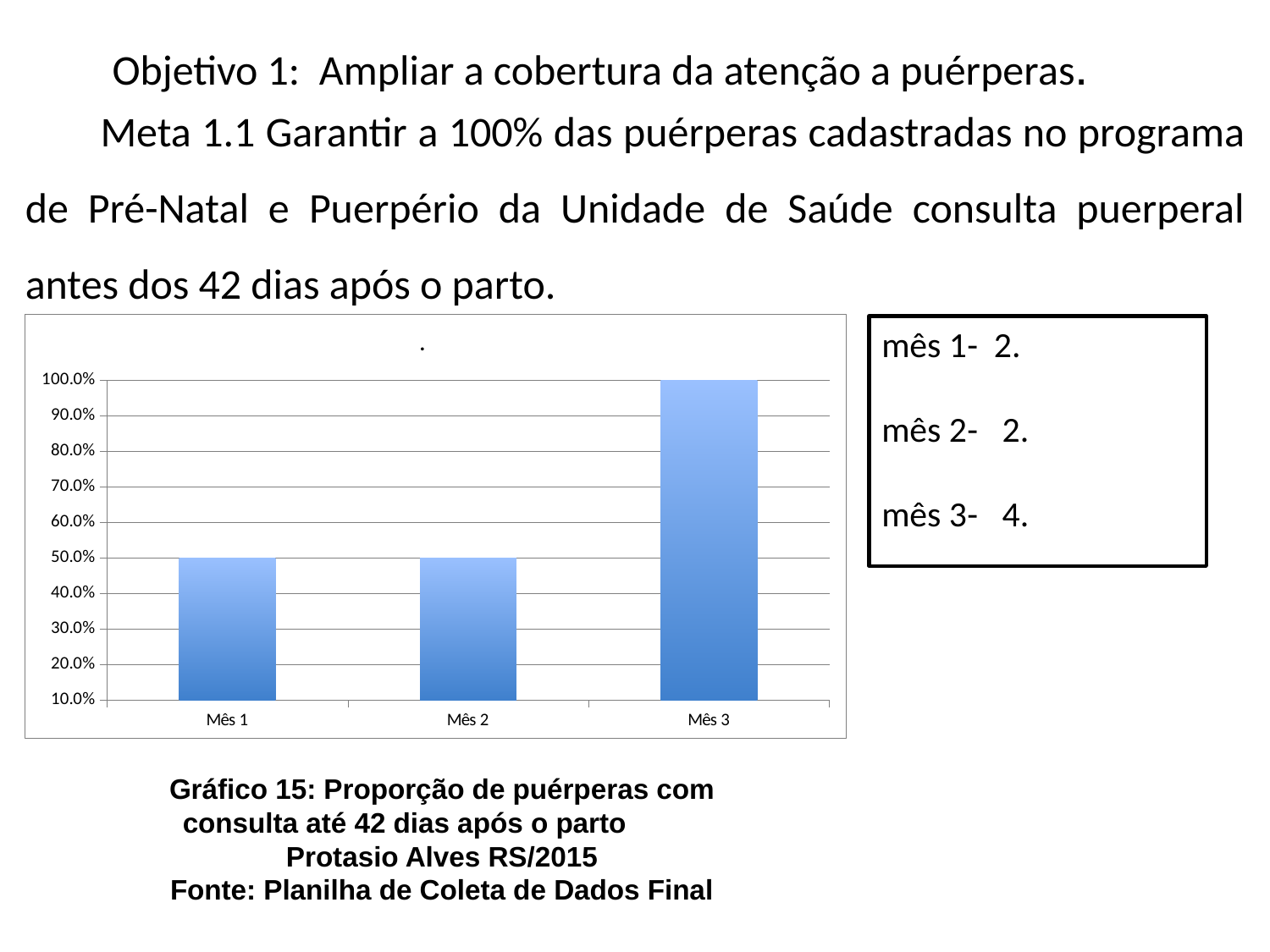
Is the value for Mês 3 greater or less than 90.0%? greater Which is larger, the value for Mês 2 or the value for Mês 3? Mês 3 What is the highest tick value shown on the vertical axis? 100.0% What is the value for Mês 1? 50.0% What is the value for Mês 3? 100.0% What is the difference between the values for Mês 3 and Mês 1? 50.0% Which month has the highest value? Mês 3 Do the values rise or fall from Mês 1 to Mês 3? rise What is the value for Mês 2? 50.0% Is the value for Mês 1 greater or less than 70.0%? less What kind of chart is shown on the slide? bar chart How many categories are shown on the x axis? 3